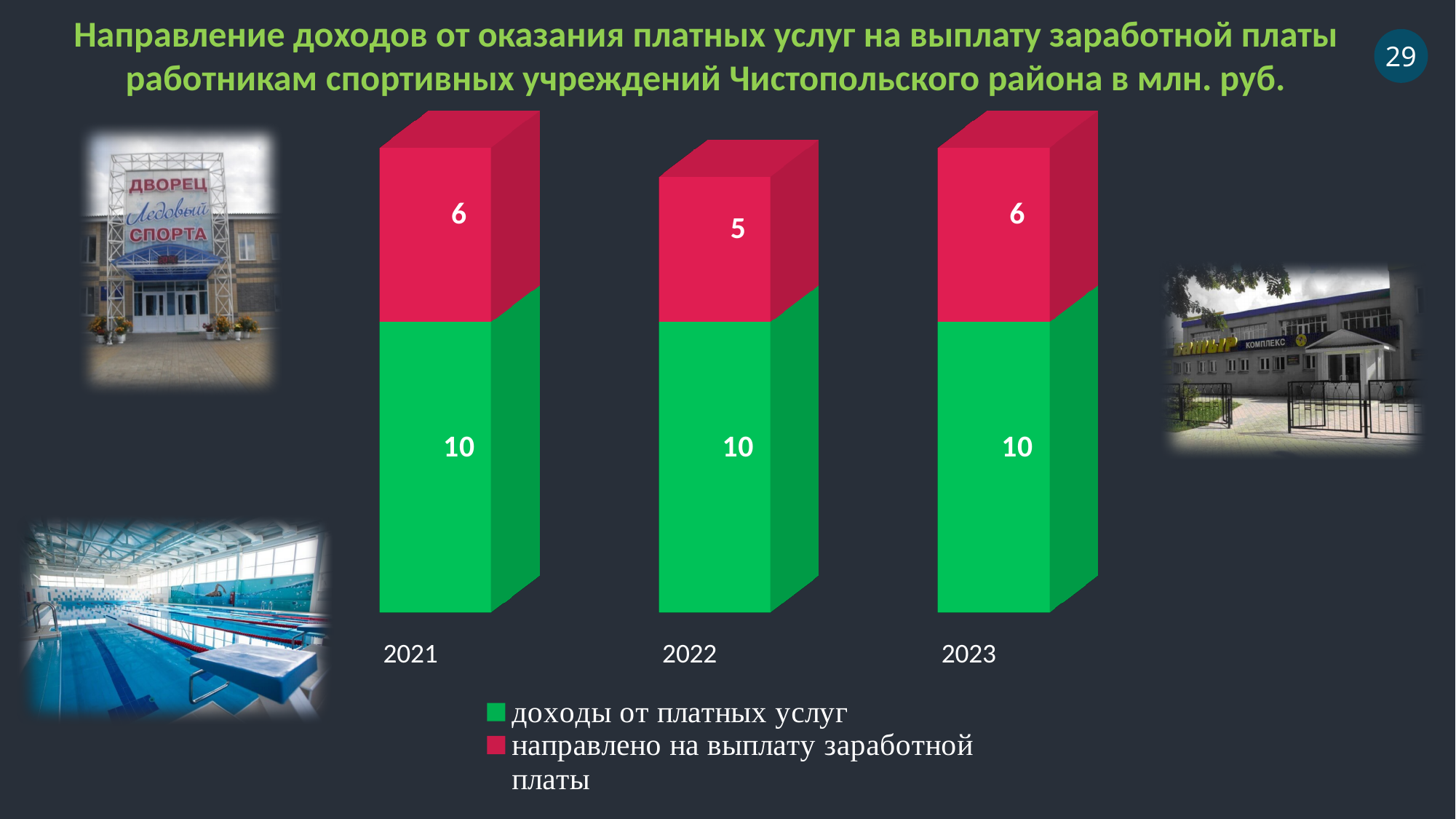
In which year is the 'направлено на выплату заработной платы' value lowest? 2022 What is the total of the stacked bar for 2021? 16 What is the value of 'направлено на выплату заработной платы' for 2022? 5 What is the difference between 'доходы от платных услуг' and 'направлено на выплату заработной платы' in 2022? 5 What kind of chart is shown on the slide? Stacked bar chart What is the value of 'направлено на выплату заработной платы' for 2023? 6 Which colour represents 'направлено на выплату заработной платы' in the legend? Red Which is larger in 2021: 'доходы от платных услуг' or 'направлено на выплату заработной платы'? доходы от платных услуг How many series does the legend list? 2 What is the value of 'доходы от платных услуг' for 2021? 10 How many years are shown on the x axis? 3 What is the total of the stacked bar for 2022? 15